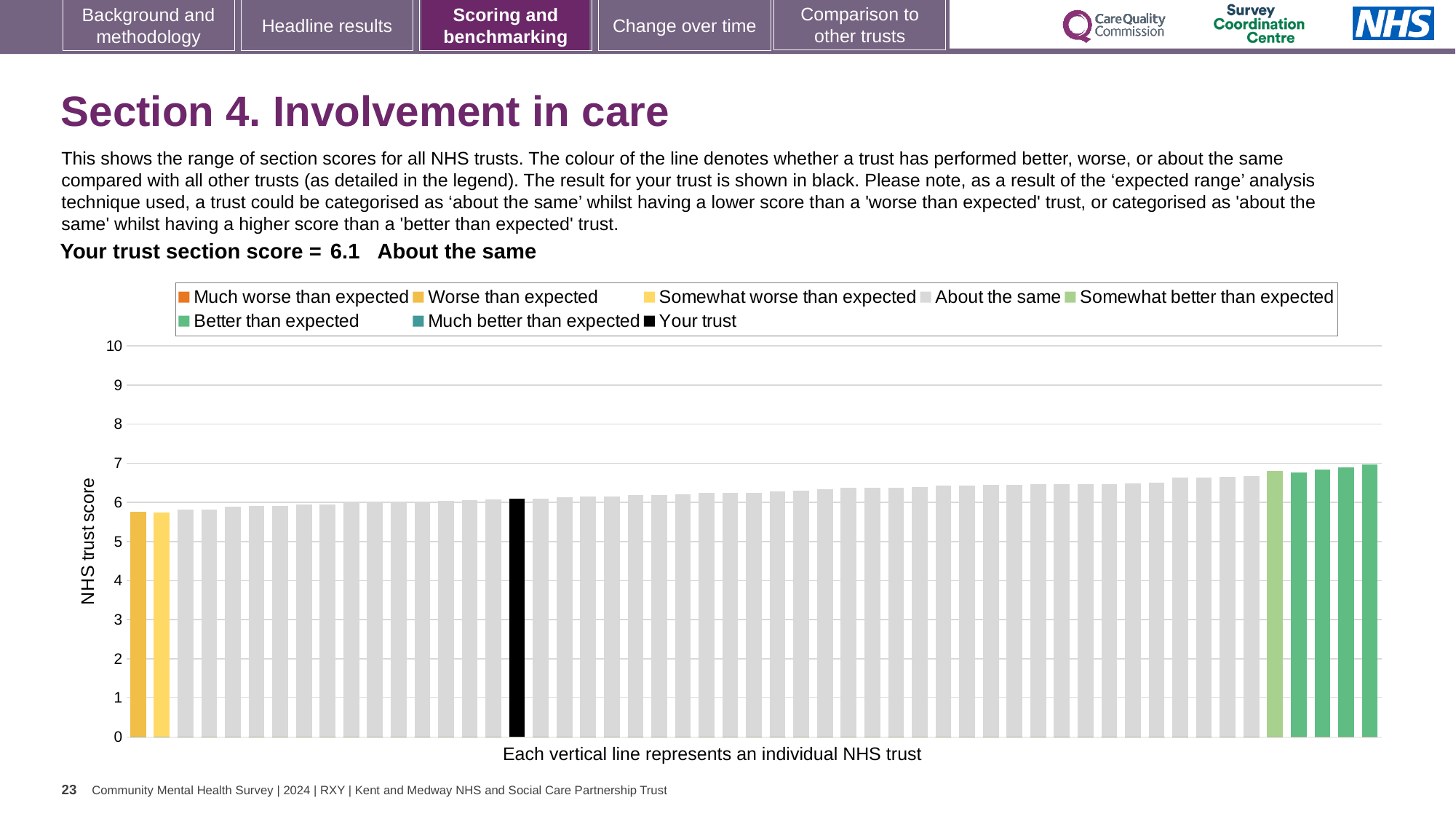
Do the bar values rise or fall from left to right along the x axis? rise What kind of chart is shown on the slide? bar chart Is the value of the black bar (your trust) greater or less than 5? greater Which performance category is your trust placed in for Section 4? About the same How many bars are coloured as 'Better than expected' (dark green)? 4 What is the section score for your trust shown on the slide? 6.1 Which legend category does the highest bar in the chart belong to? Better than expected How many bars are coloured as 'Worse than expected' (dark yellow)? 1 How many entries does the chart legend list? 8 What is the label on the vertical axis of the chart? NHS trust score Is the value of the black bar (your trust) greater or less than 7? less Is the lowest bar in the chart greater or less than 5? greater